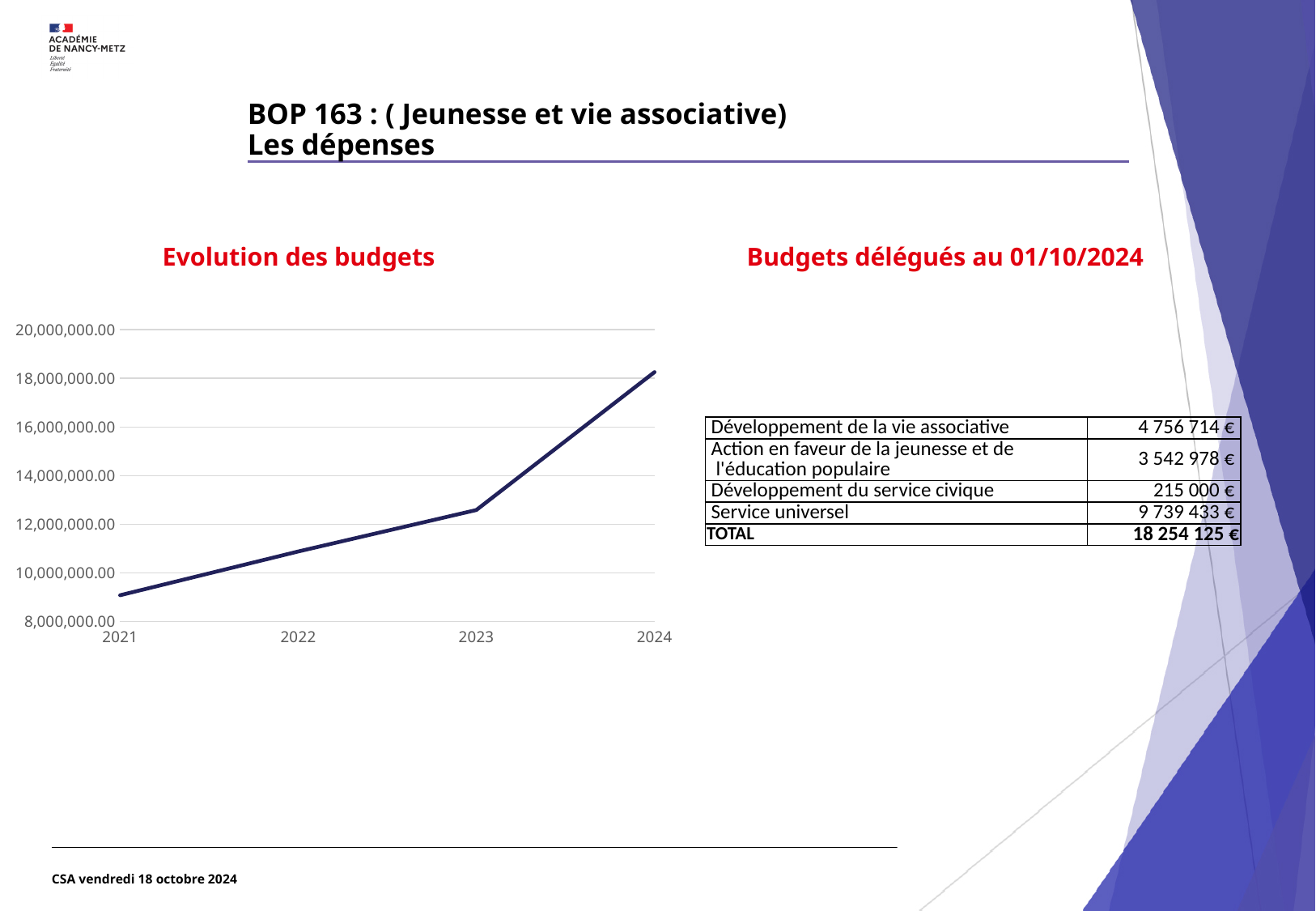
In the "Evolution des budgets" chart, is the value for 2021 greater or less than 10,000,000.00? less What kind of chart is shown under the title "Evolution des budgets"? line chart What is the title of the chart on the left of the slide? Evolution des budgets In the "Evolution des budgets" chart, is the value for 2023 greater or less than 12,000,000.00? greater How many years are plotted on the x axis of the "Evolution des budgets" chart? 4 In the "Evolution des budgets" chart, which year has the lowest value? 2021 In the "Evolution des budgets" chart, is the value for 2024 greater or less than 16,000,000.00? greater What is the first year shown on the x axis of the "Evolution des budgets" chart? 2021 In the "Evolution des budgets" chart, which year has the highest value? 2024 In the "Evolution des budgets" chart, do the values rise or fall from 2021 to 2024? rise In the "Evolution des budgets" chart, which year has the larger value, 2022 or 2023? 2023